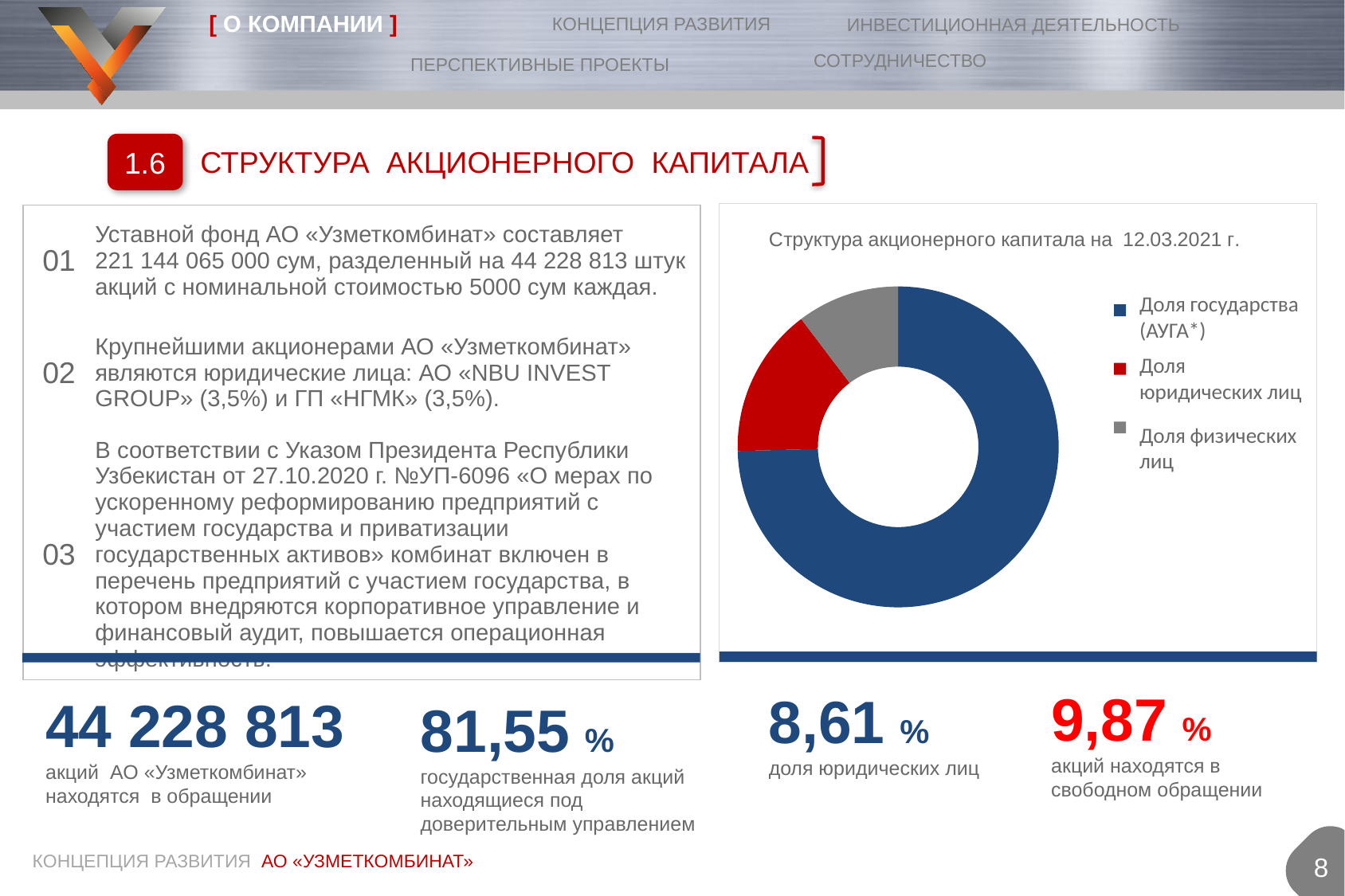
What colour represents Доля юридических лиц in the chart? red How many entries does the chart legend list? 3 Which slice is larger: Доля государства (АУГА*) or Доля физических лиц? Доля государства (АУГА*) Which slice is larger: Доля государства (АУГА*) or Доля юридических лиц? Доля государства (АУГА*) What kind of chart is shown on the slide? pie chart (donut) What is the title of the chart? Структура акционерного капитала на 12.03.2021 г. Which category has the largest slice in the pie chart? Доля государства (АУГА*) How many slices does the pie chart have? 3